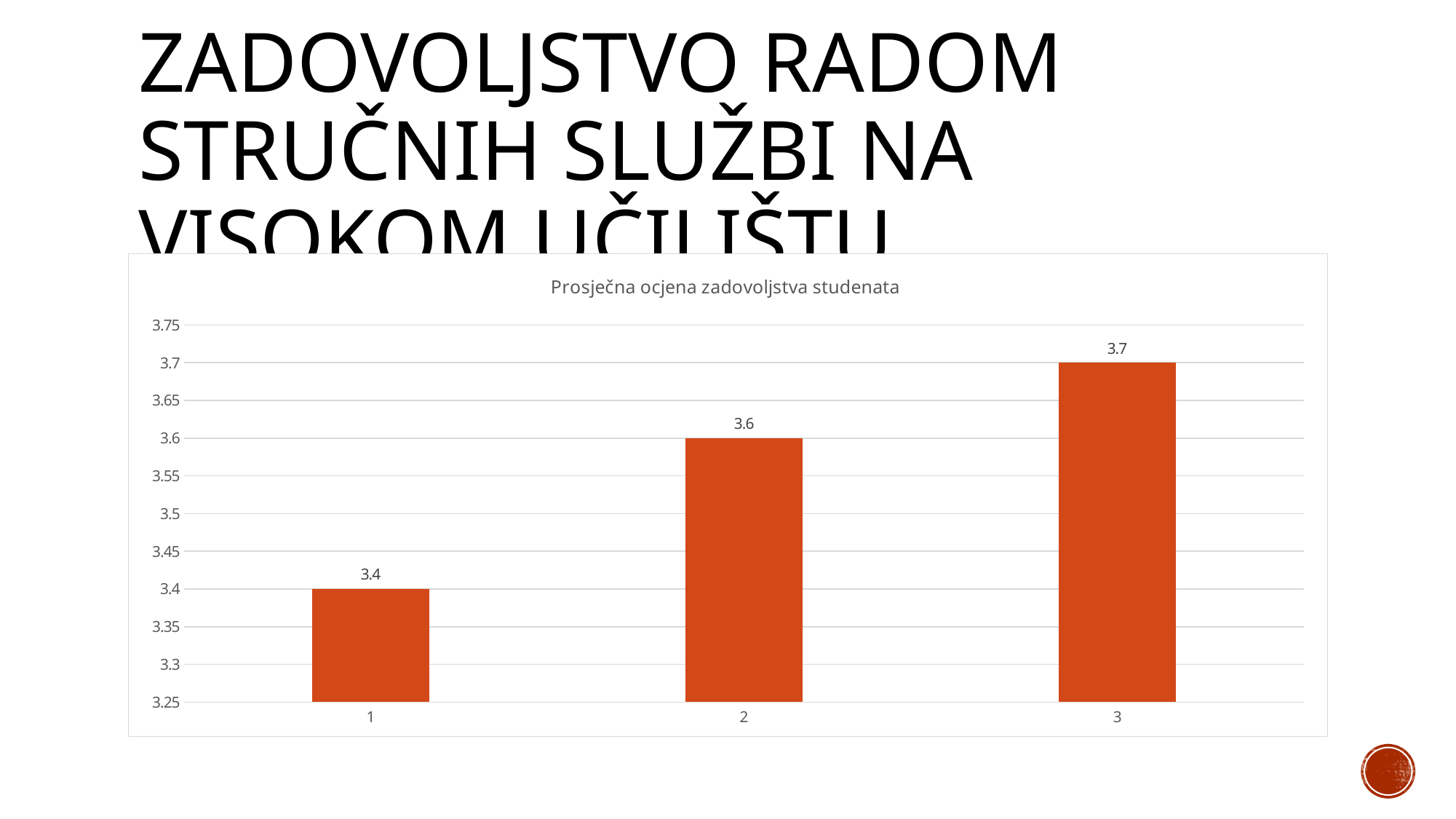
What is the difference between the values for category 3 and category 1? 0.3 How many categories are shown on the x axis? 3 What kind of chart is shown? bar chart What is the title of the chart? Prosječna ocjena zadovoljstva studenata What is the value for category 1? 3.4 Is the value for category 2 greater or less than 3.5? greater Do the values rise or fall from category 1 to category 3? rise Which category has the lowest value? 1 Which is larger, the value for category 2 or category 1? 2 What is the value for category 2? 3.6 What is the value for category 3? 3.7 Which category has the highest value? 3